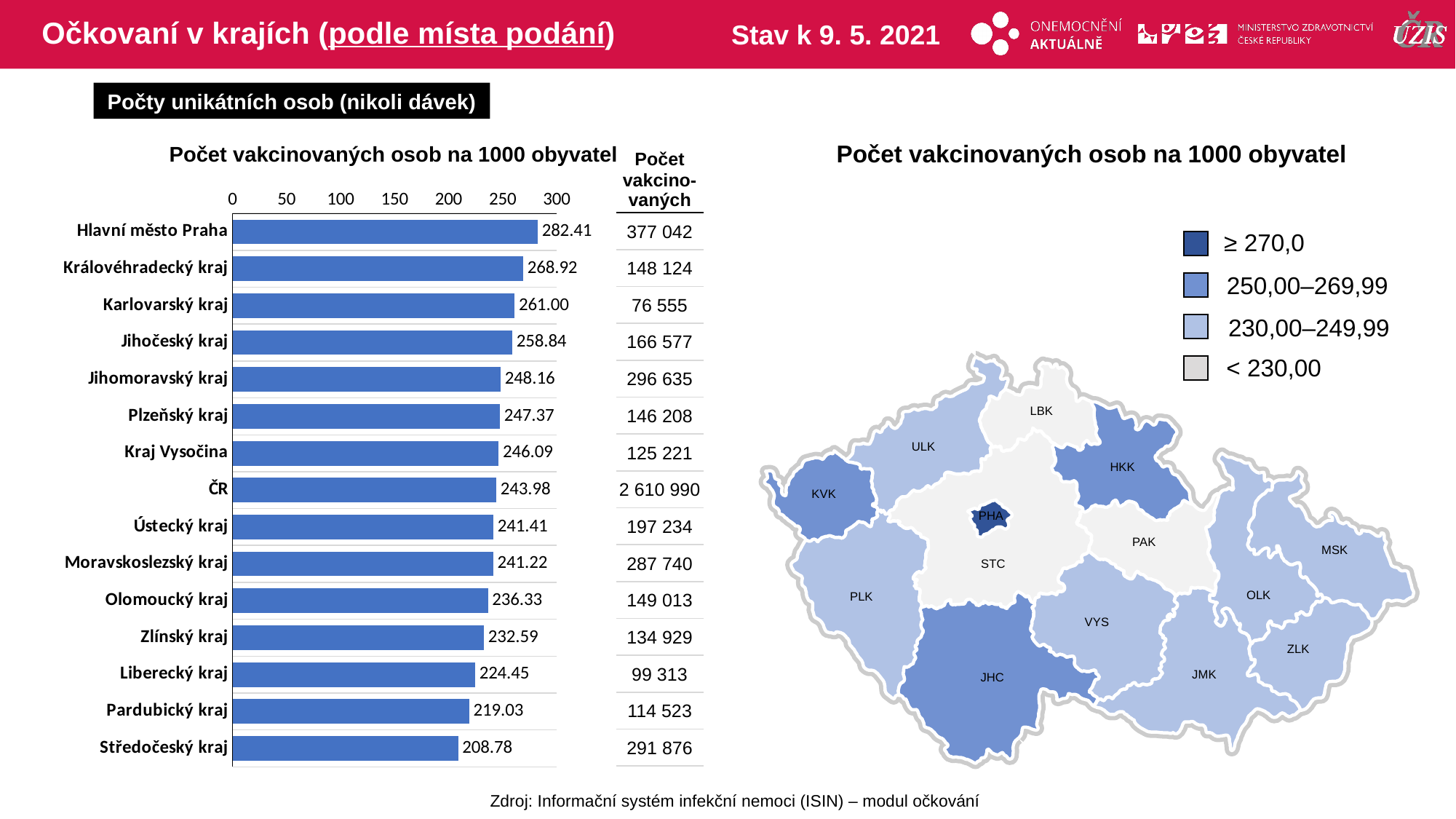
In the bar chart 'Počet vakcinovaných osob na 1000 obyvatel', what is the value for Jihočeský kraj? 258.84 In the bar chart 'Počet vakcinovaných osob na 1000 obyvatel', is the value for Liberecký kraj greater or less than 250? less In the map legend on the right side of the slide, what range does the second-darkest blue shade represent? 250,00–269,99 In the bar chart 'Počet vakcinovaných osob na 1000 obyvatel', which category has the lowest value? Středočeský kraj In the bar chart 'Počet vakcinovaných osob na 1000 obyvatel', what is the value for ČR? 243.98 In the table column 'Počet vakcinovaných' next to the bar chart, what is the value for Jihomoravský kraj? 296 635 In the bar chart 'Počet vakcinovaných osob na 1000 obyvatel', what is the value for Hlavní město Praha? 282.41 In the bar chart 'Počet vakcinovaných osob na 1000 obyvatel', what is the difference between the values for Hlavní město Praha and Středočeský kraj? 73.63 In the bar chart 'Počet vakcinovaných osob na 1000 obyvatel', which is larger: the value for Karlovarský kraj or the value for Zlínský kraj? Karlovarský kraj How many bars are shown in the bar chart 'Počet vakcinovaných osob na 1000 obyvatel'? 15 In the bar chart 'Počet vakcinovaných osob na 1000 obyvatel', which category has the highest value? Hlavní město Praha What kind of chart is used on the left side of the slide to show 'Počet vakcinovaných osob na 1000 obyvatel'? bar chart